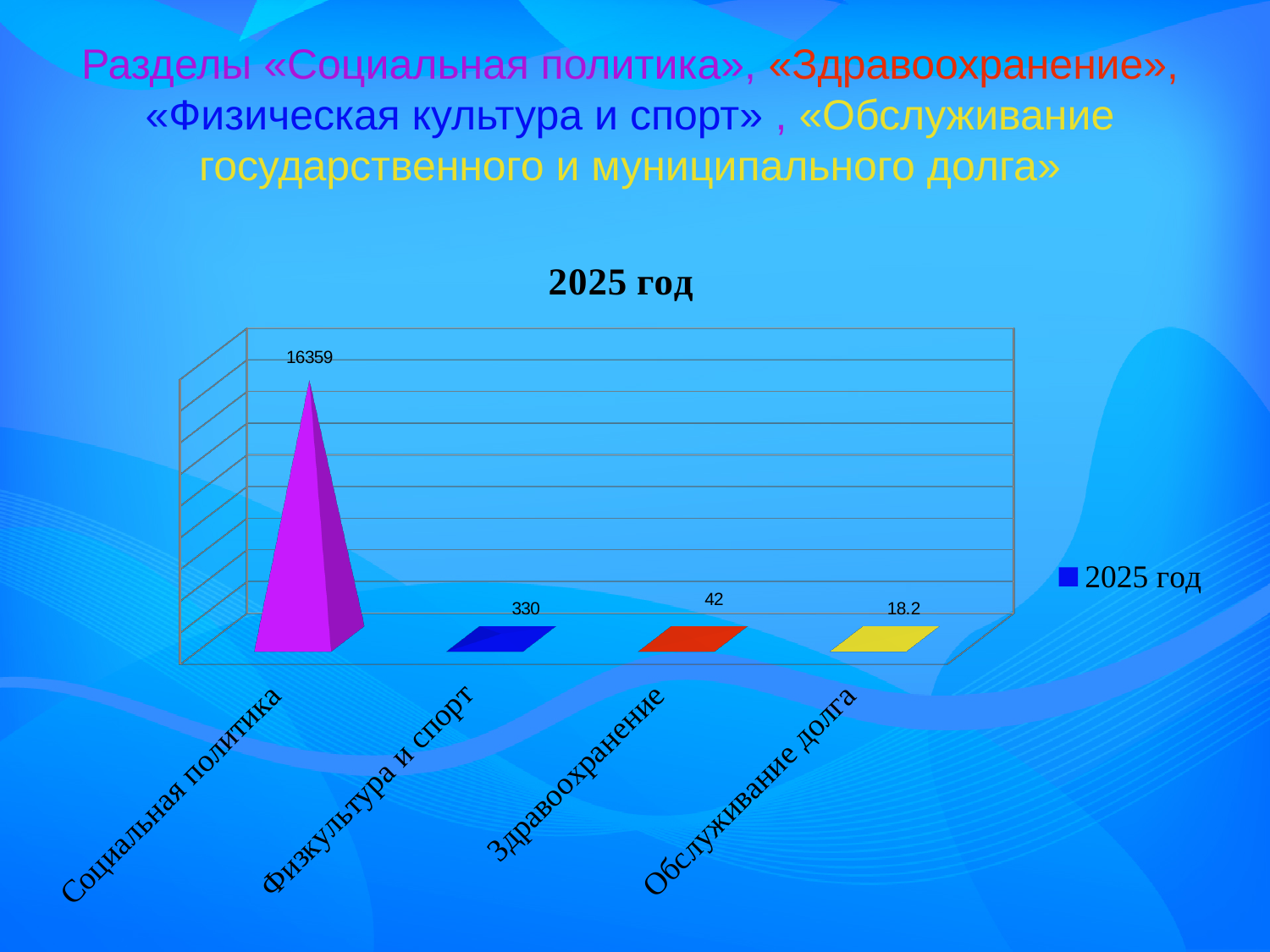
What is the difference between the values for Здравоохранение and Обслуживание долга? 23.8 What is the value for Здравоохранение? 42 How many series does the legend list? 1 What is the value for Социальная политика? 16359 Which is larger, the value for Физкультура и спорт or the value for Здравоохранение? Физкультура и спорт What is the title of the chart? 2025 год What is the difference between the values for Физкультура и спорт and Здравоохранение? 288 How many categories are shown on the chart? 4 What is the value for Обслуживание долга? 18.2 Which category has the lowest value? Обслуживание долга Which category has the highest value? Социальная политика What is the value for Физкультура и спорт? 330